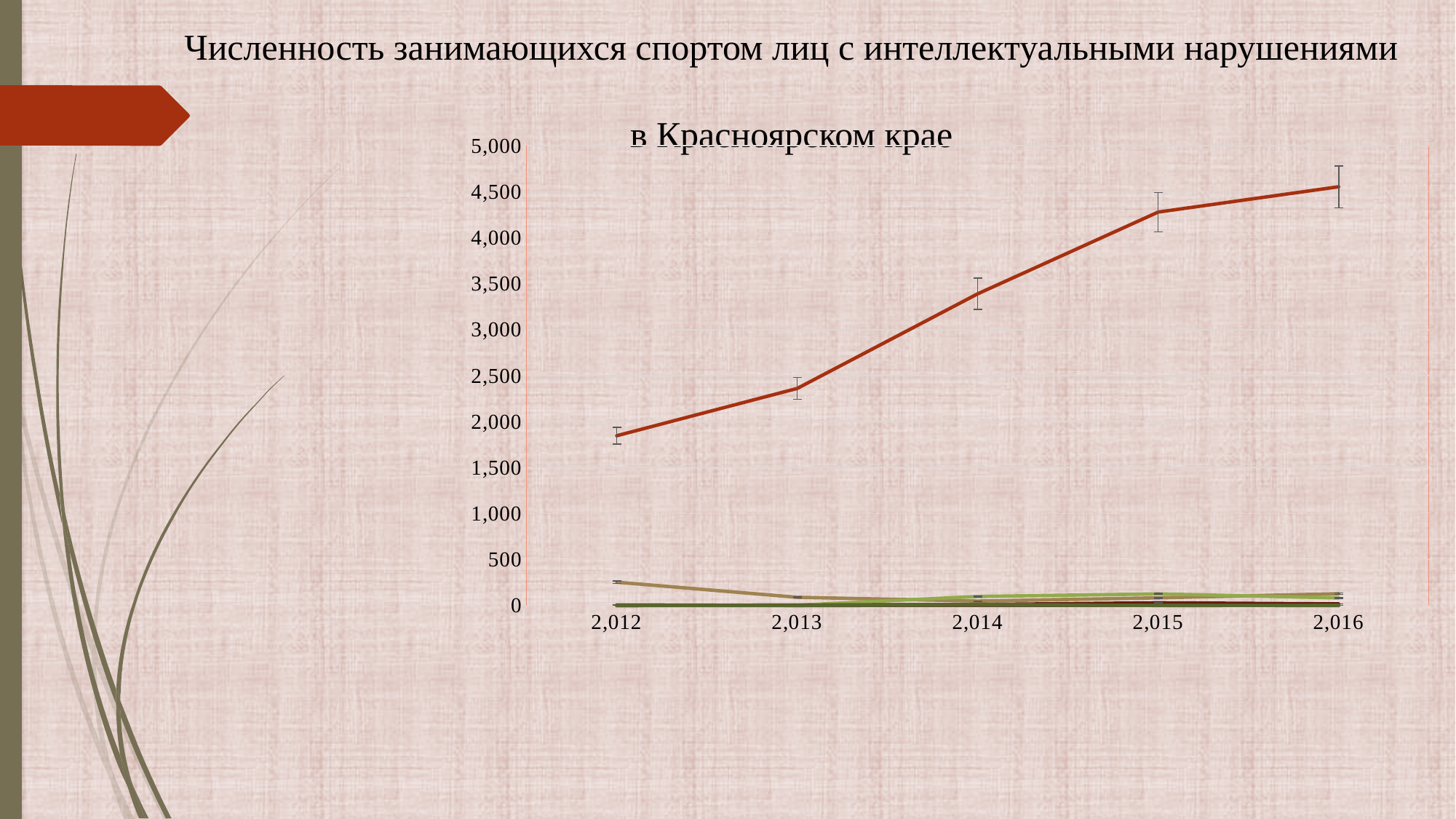
Which is larger for the red (top) line: the value for 2,013 or the value for 2,015? 2,015 Is the value of the red (top) line for 2,013 greater or less than 2,500? less In which year does the red (top) line reach its highest value? 2,016 In which year does the red (top) line have its lowest value? 2,012 Is the value of the red (top) line for 2,015 greater or less than 4,000? greater Is the value of the red (top) line for 2,012 greater or less than 1,500? greater What kind of chart is shown on the slide? line chart How many years are shown along the x axis of the chart? 5 Does the red (top) line rise or fall from 2,012 to 2,016? rises What is the title of the chart? Численность занимающихся спортом лиц с интеллектуальными нарушениями в Красноярском крае